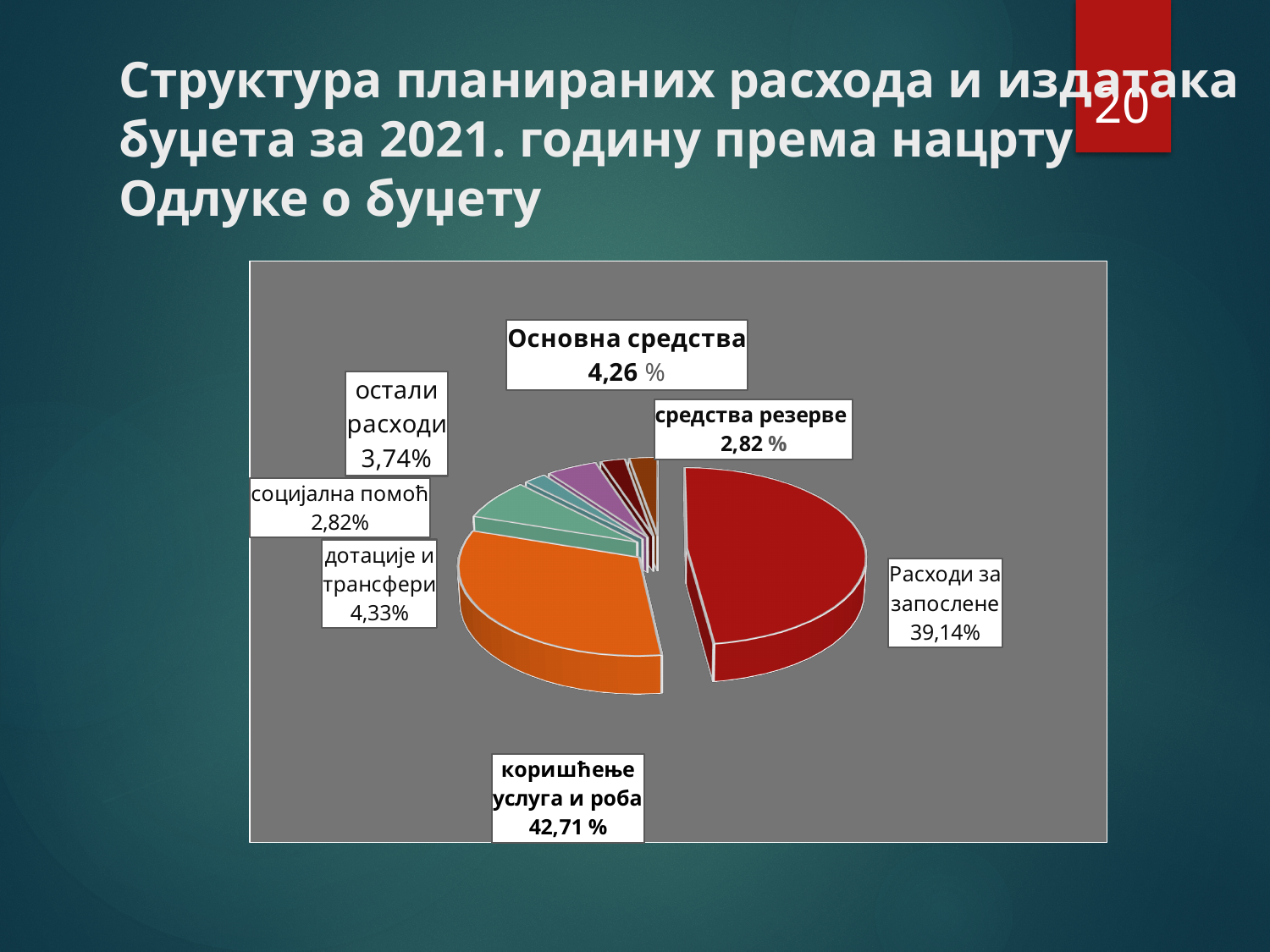
What is the difference between the shares of коришћење услуга и роба and Расходи за запослене? 3,57% What share of the pie is labelled for коришћење услуга и роба? 42,71 % What is the value shown for средства резерве? 2,82 % What type of chart is shown on the slide? pie chart Which category has the largest share of the pie? коришћење услуга и роба Which is larger, the share for дотације и трансфери or the share for остали расходи? дотације и трансфери What is the value shown for дотације и трансфери? 4,33% What is the value shown for Основна средства? 4,26 % What colour is the slice for Расходи за запослене? red What is the value shown for Расходи за запослене? 39,14% How many slices does the pie chart have? 7 What is the value shown for остали расходи? 3,74%